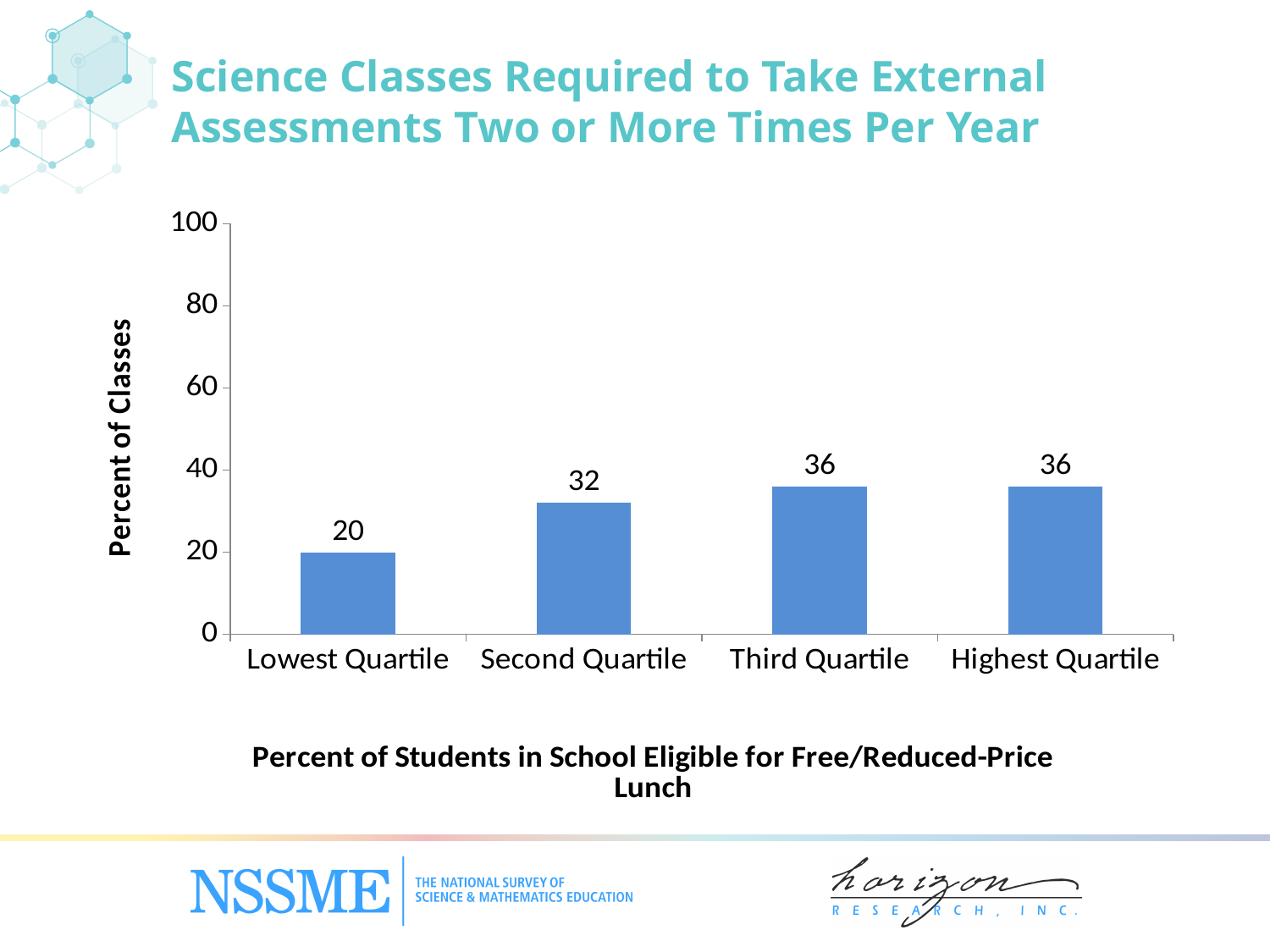
Is the value for Third Quartile greater or less than 40? less What is the value for Lowest Quartile? 20 What kind of chart is shown on the slide? bar chart Which is larger, the value for Second Quartile or the value for Lowest Quartile? Second Quartile What is the label of the y axis? Percent of Classes How many categories are shown on the x axis? 4 What is the value for Second Quartile? 32 What is the difference between the values for Highest Quartile and Second Quartile? 4 Which category has the lowest value? Lowest Quartile What is the value for Third Quartile? 36 Do the values rise or fall from Lowest Quartile to Third Quartile? rise What is the difference between the values for Second Quartile and Lowest Quartile? 12